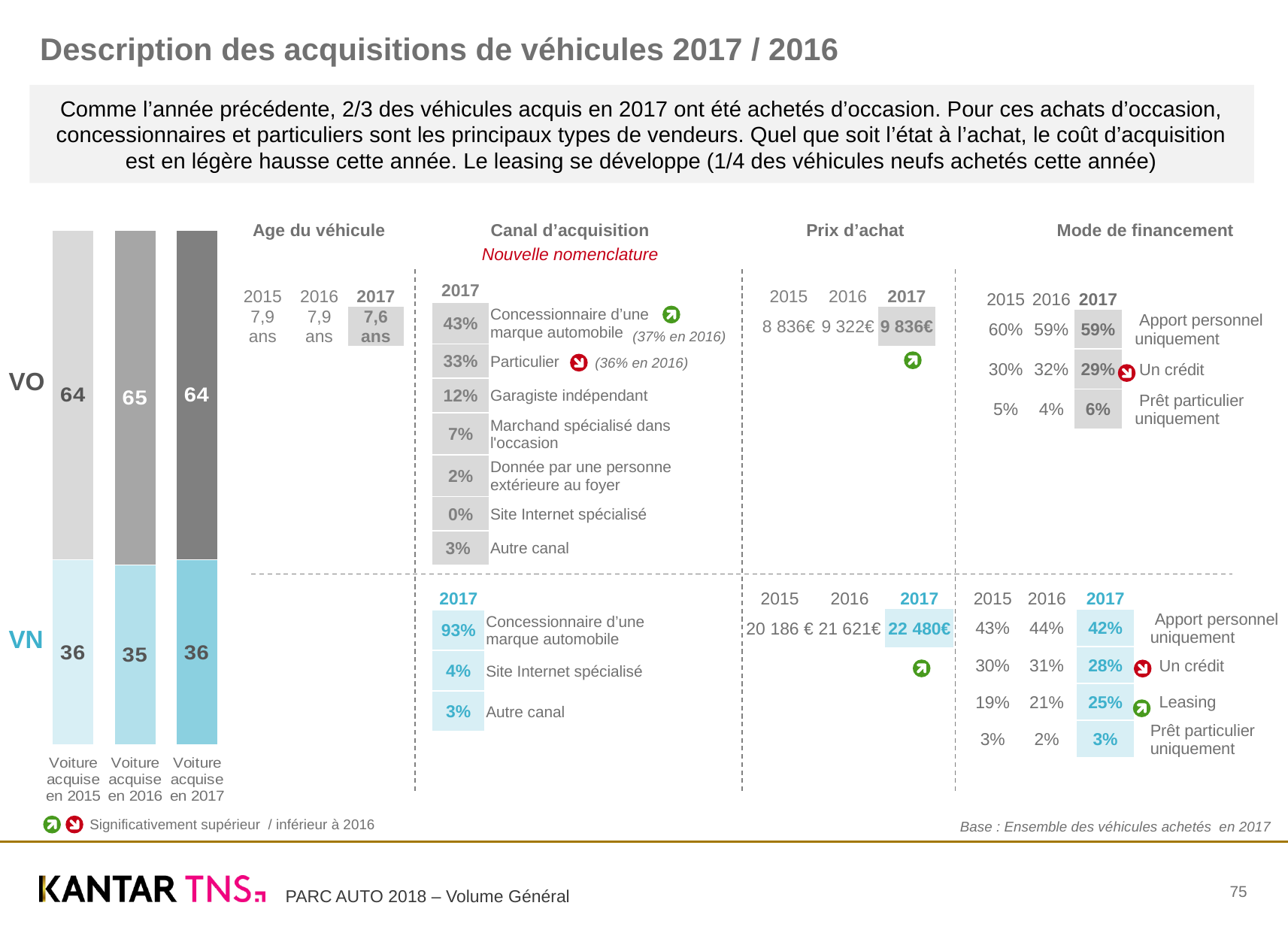
In the stacked bar chart, what is the VO value for 'Voiture acquise en 2016'? 65 In the stacked bar chart, what is the VN value for 'Voiture acquise en 2017'? 36 How many bars are there in the stacked bar chart? 3 In the stacked bar chart, which segment is larger for 'Voiture acquise en 2015', VO or VN? VO In the stacked bar chart, what is the total of the bar for 'Voiture acquise en 2017'? 100 In the stacked bar chart, what is the VO value for 'Voiture acquise en 2017'? 64 In the stacked bar chart, what is the VN value for 'Voiture acquise en 2015'? 36 In the stacked bar chart, which year has the lowest VN value? Voiture acquise en 2016 In the stacked bar chart, which year has the highest VO value? Voiture acquise en 2016 How many segments (series) make up each bar in the stacked bar chart? 2 What kind of chart is shown on the left of the slide? stacked bar chart In the stacked bar chart, what is the difference between the VO and VN values for 'Voiture acquise en 2016'? 30